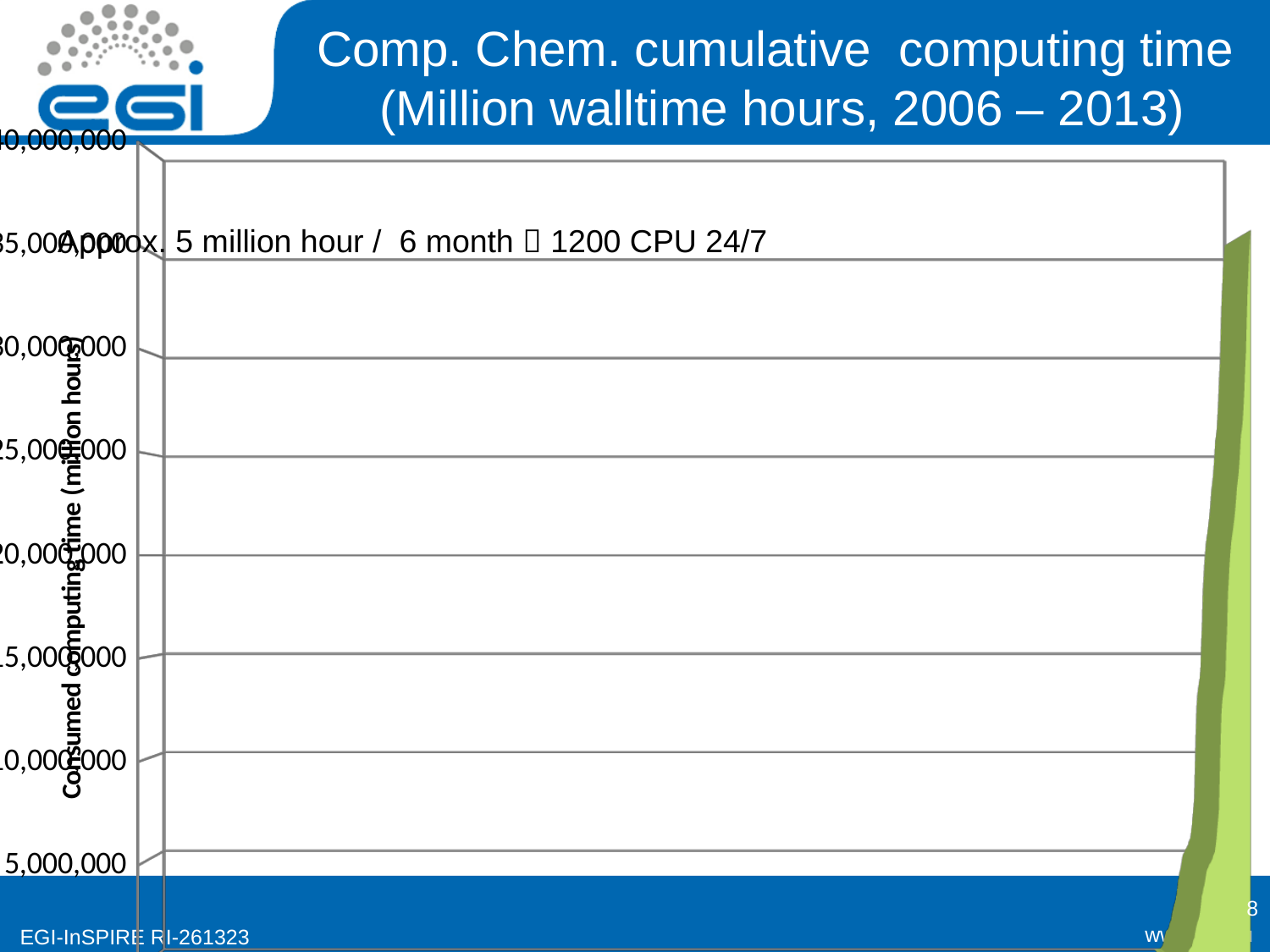
What period does the chart title say the cumulative computing time covers? 2006 – 2013 What is the title of the y axis of the chart? Consumed computing time (million hours) What is the lowest y-axis tick label shown on the chart? 5,000,000 What kind of chart is shown on the slide? area chart Do the plotted values rise or fall along the x axis of the chart? rise